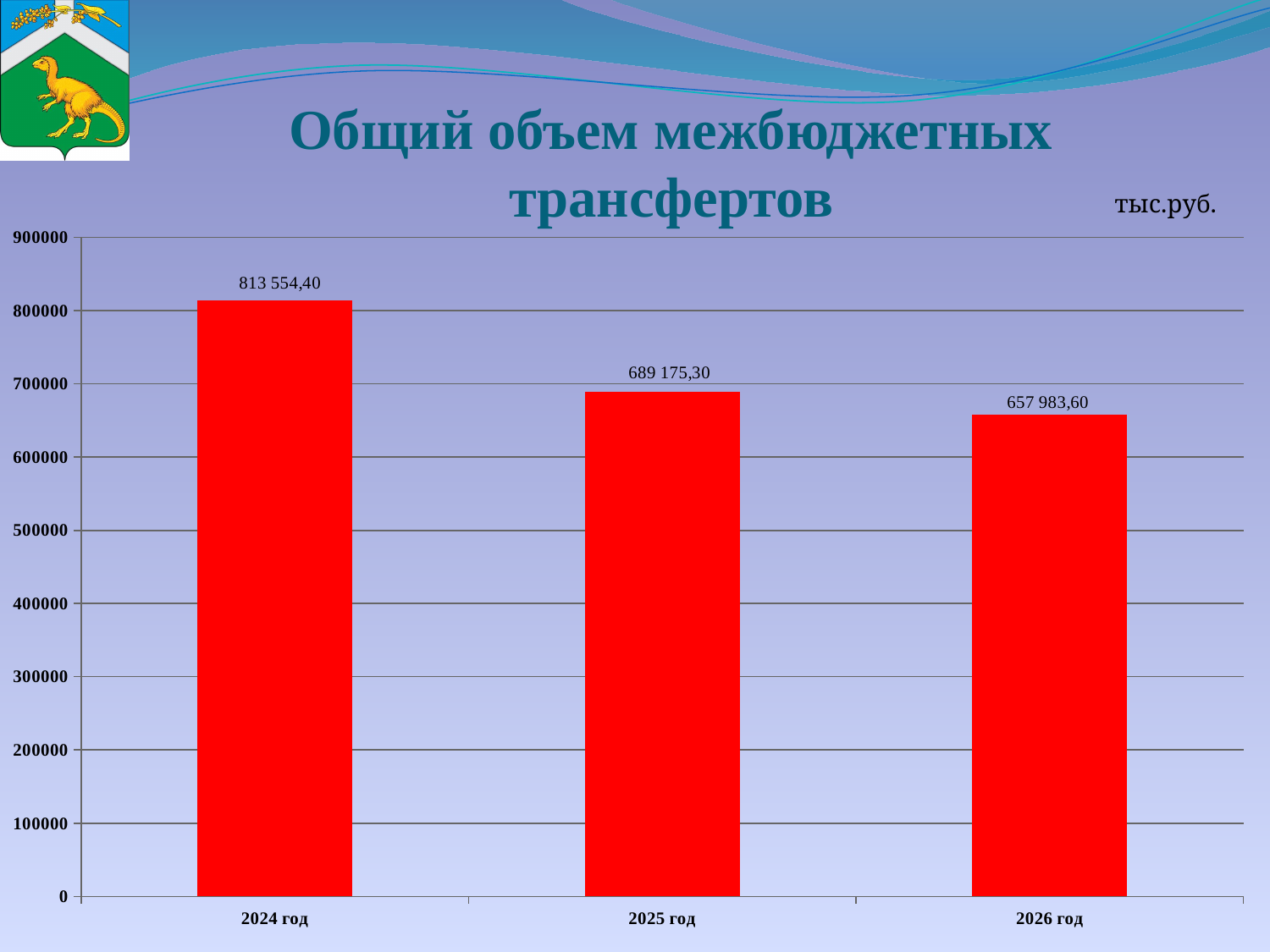
What is the difference between the values for 2024 год and 2025 год? 124 379,10 How many years are shown on the chart? 3 Which year has the lowest value? 2026 год What is the value for 2025 год? 689 175,30 What kind of chart is shown on the slide? bar chart What is the difference between the values for 2025 год and 2026 год? 31 191,70 Is the value for 2024 год greater or less than 800000? greater Do the values rise or fall from 2024 год to 2026 год? fall Which is larger, the value for 2025 год or the value for 2026 год? 2025 год Which year has the highest value? 2024 год What is the value for 2024 год? 813 554,40 What is the value for 2026 год? 657 983,60